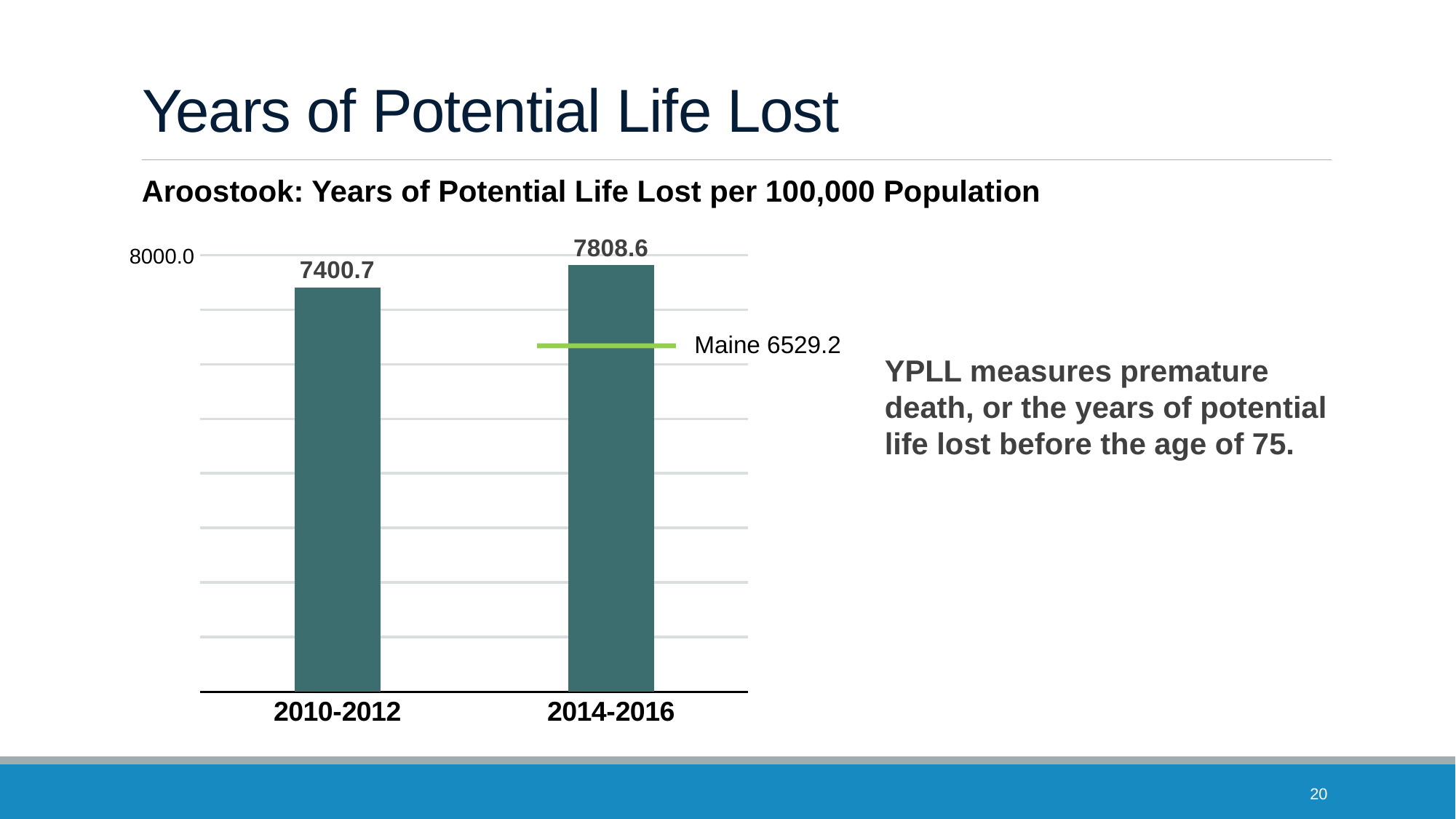
What kind of chart is this? bar chart What is the title of the chart? Aroostook: Years of Potential Life Lost per 100,000 Population What is the value for 2010-2012? 7400.7 Do the values rise or fall from 2010-2012 to 2014-2016? rise Which period has the lower value? 2010-2012 What is the difference between the 2014-2016 value and the 2010-2012 value? 407.9 Is the value for 2010-2012 greater or less than 8000.0? less Which period has the higher value? 2014-2016 What is the value for 2014-2016? 7808.6 How many time periods are plotted as bars? 2 What is the Maine value shown by the reference line? 6529.2 Is the value for 2014-2016 larger or smaller than the Maine value? larger